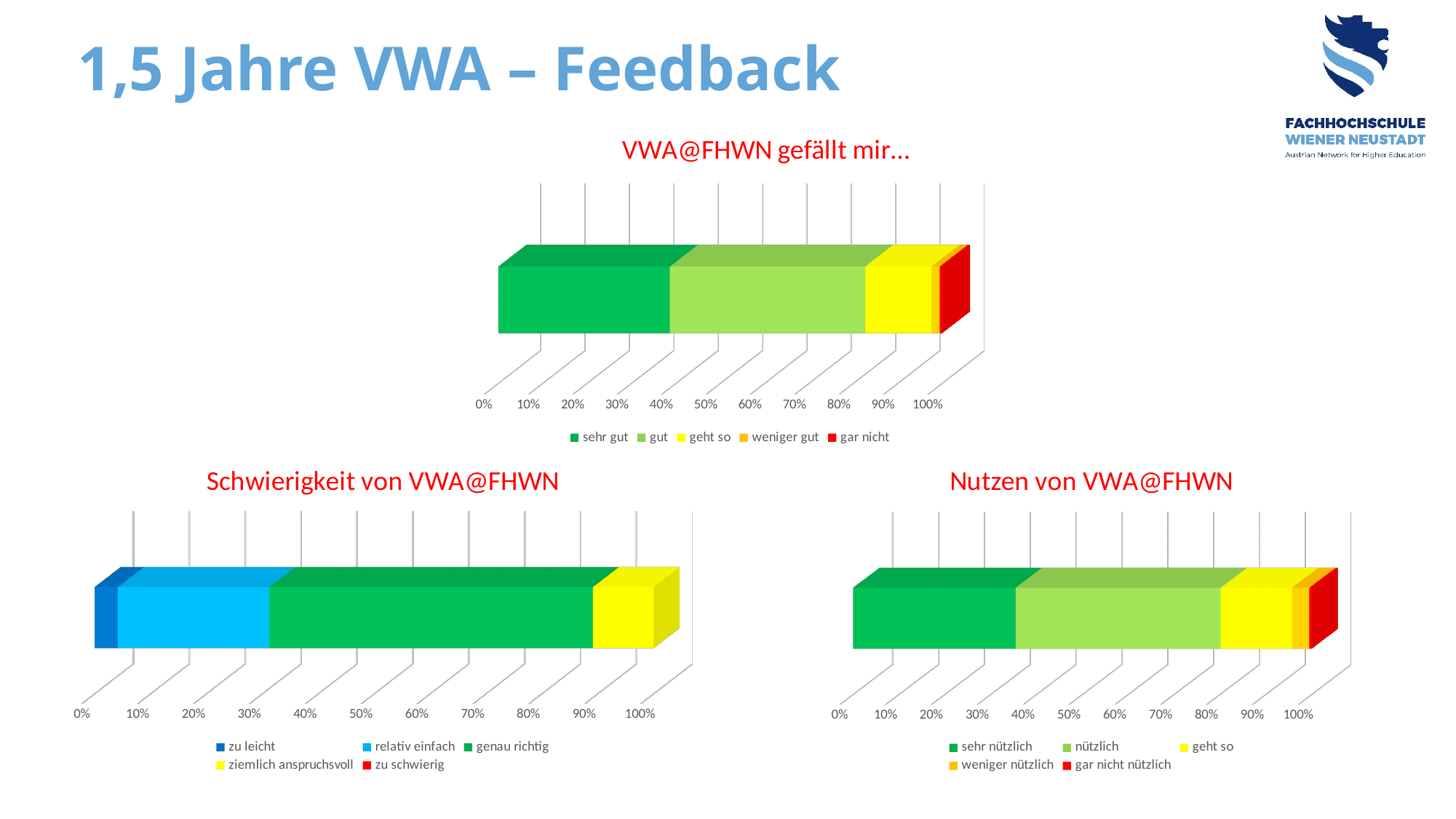
In the chart 'Schwierigkeit von VWA@FHWN', is the share for 'relativ einfach' greater or less than 40%? less What type of chart is 'VWA@FHWN gefällt mir...'? Stacked bar chart In the chart 'Nutzen von VWA@FHWN', what colour represents 'gar nicht nützlich'? Red In the chart 'Schwierigkeit von VWA@FHWN', is the share for 'genau richtig' greater or less than 50%? greater In the chart 'VWA@FHWN gefällt mir...', which series takes up the largest share of the bar? gut In the chart 'Nutzen von VWA@FHWN', is the share for 'sehr nützlich' greater or less than 50%? less In the chart 'Nutzen von VWA@FHWN', which series takes up the largest share of the bar? nützlich In the chart 'VWA@FHWN gefällt mir...', how many series does the legend list? 5 How many charts are shown on the slide? 3 In the chart 'Schwierigkeit von VWA@FHWN', which is larger, the share for 'zu leicht' or the share for 'relativ einfach'? relativ einfach In the chart 'Schwierigkeit von VWA@FHWN', which series takes up the largest share of the bar? genau richtig